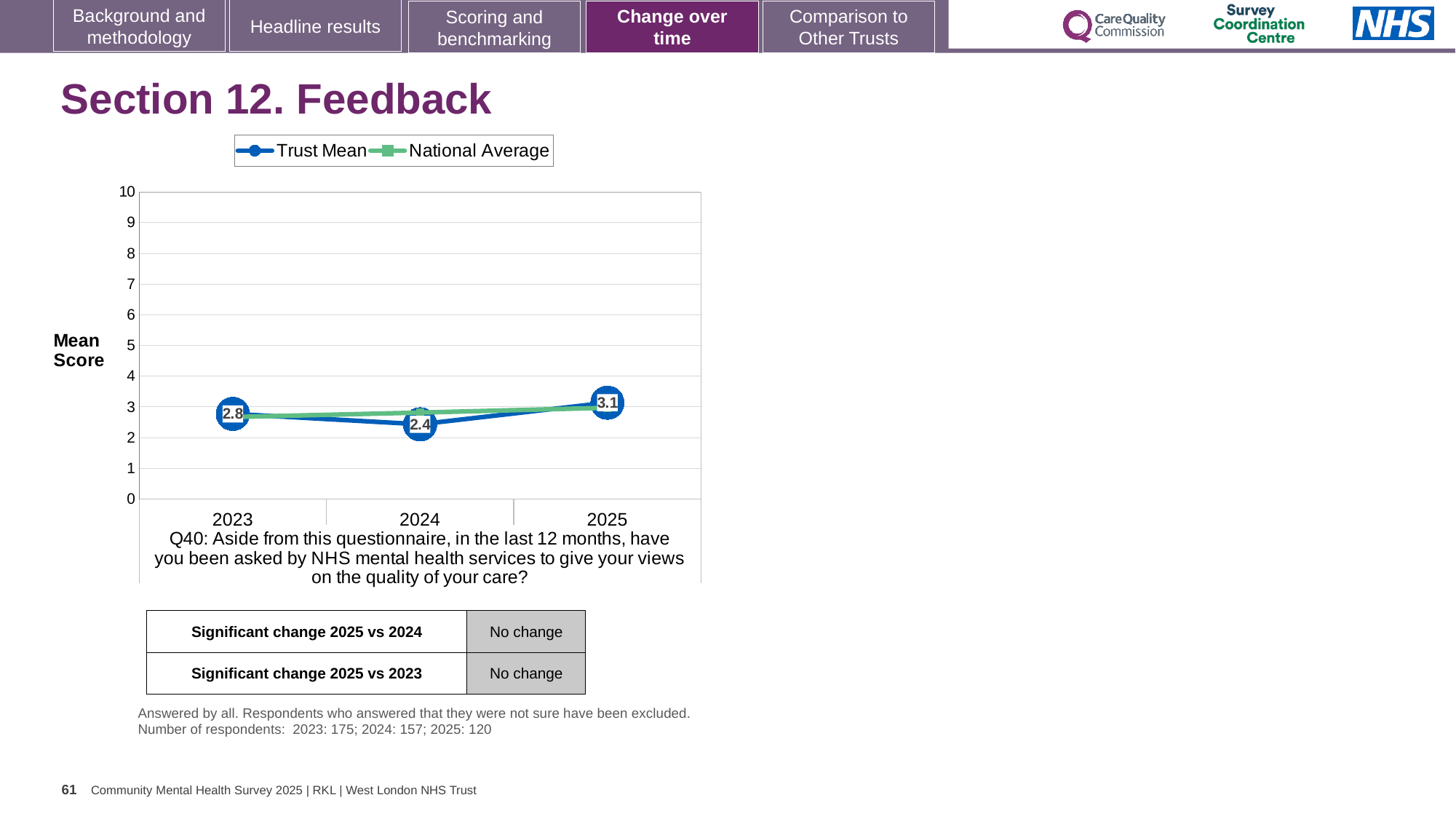
In which year is the Trust Mean highest? 2025 In which year is the Trust Mean lowest? 2024 How many years are plotted on the x axis? 3 Which is larger, the Trust Mean for 2023 or for 2025? 2025 What is the Trust Mean value for 2024? 2.4 Does the Trust Mean rise or fall from 2024 to 2025? rise What is the Trust Mean value for 2025? 3.1 Is the National Average value for 2025 greater or less than 5? less What is the Trust Mean value for 2023? 2.8 What kind of chart is shown on the slide? line chart How many series does the legend list? 2 What is the difference between the Trust Mean in 2025 and in 2024? 0.7